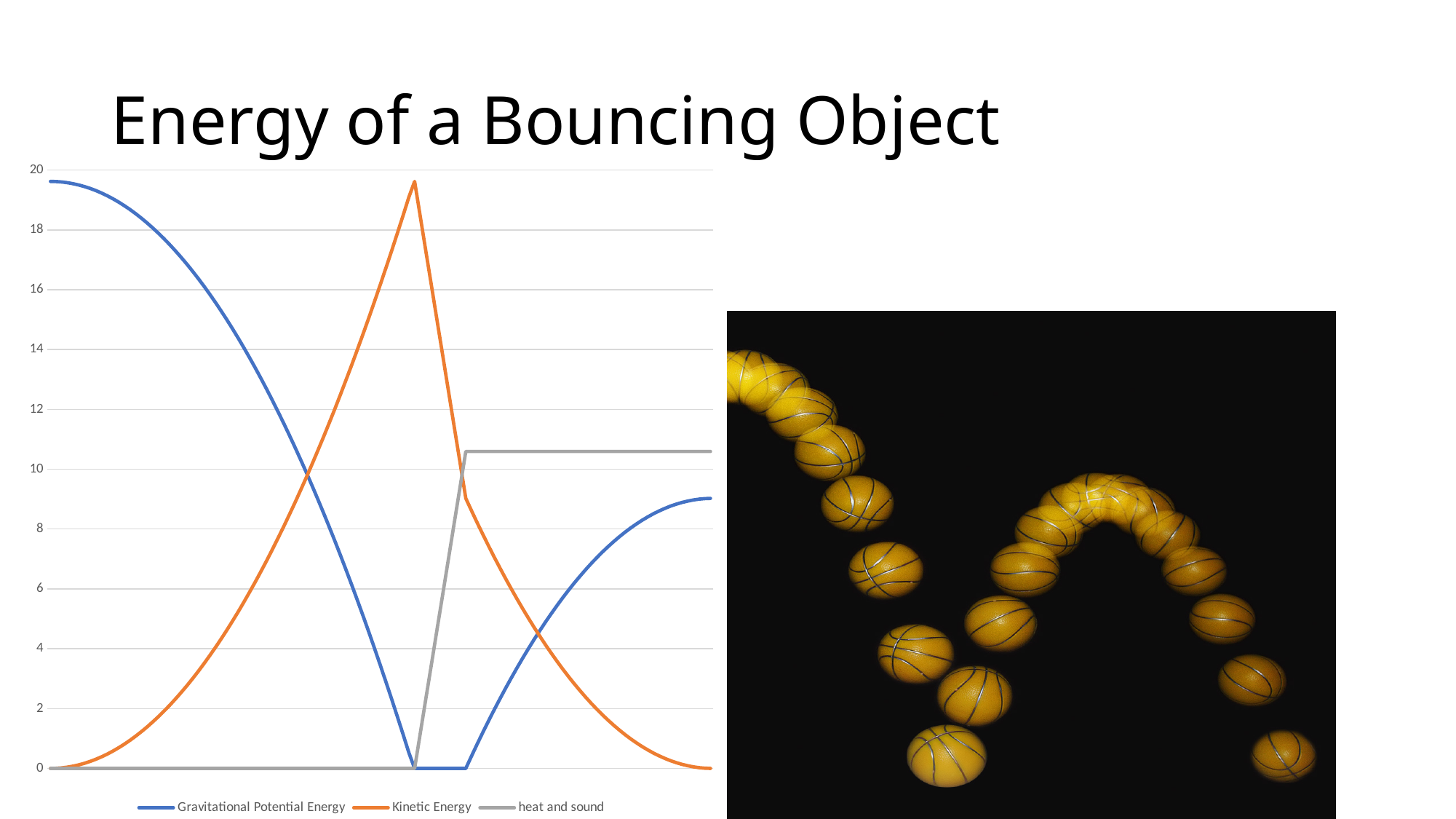
How many series does the chart's legend list? 3 Is the value of Gravitational Potential Energy at the right end of the chart greater or less than 10? less At the right end of the chart, which is larger: Gravitational Potential Energy or Kinetic Energy? Gravitational Potential Energy What are the three series named in the chart's legend? Gravitational Potential Energy, Kinetic Energy, heat and sound Is the peak value of the Kinetic Energy line greater or less than 18? greater What kind of chart is shown on the slide? line chart Does the Kinetic Energy line rise or fall over the last part of the chart, after its peak? fall Is the starting value of the Gravitational Potential Energy line greater or less than 18? greater Which colour is used for the Kinetic Energy line? orange Which series reaches the lowest maximum value on the chart? heat and sound Does the Gravitational Potential Energy line rise or fall over the first part of the chart? fall